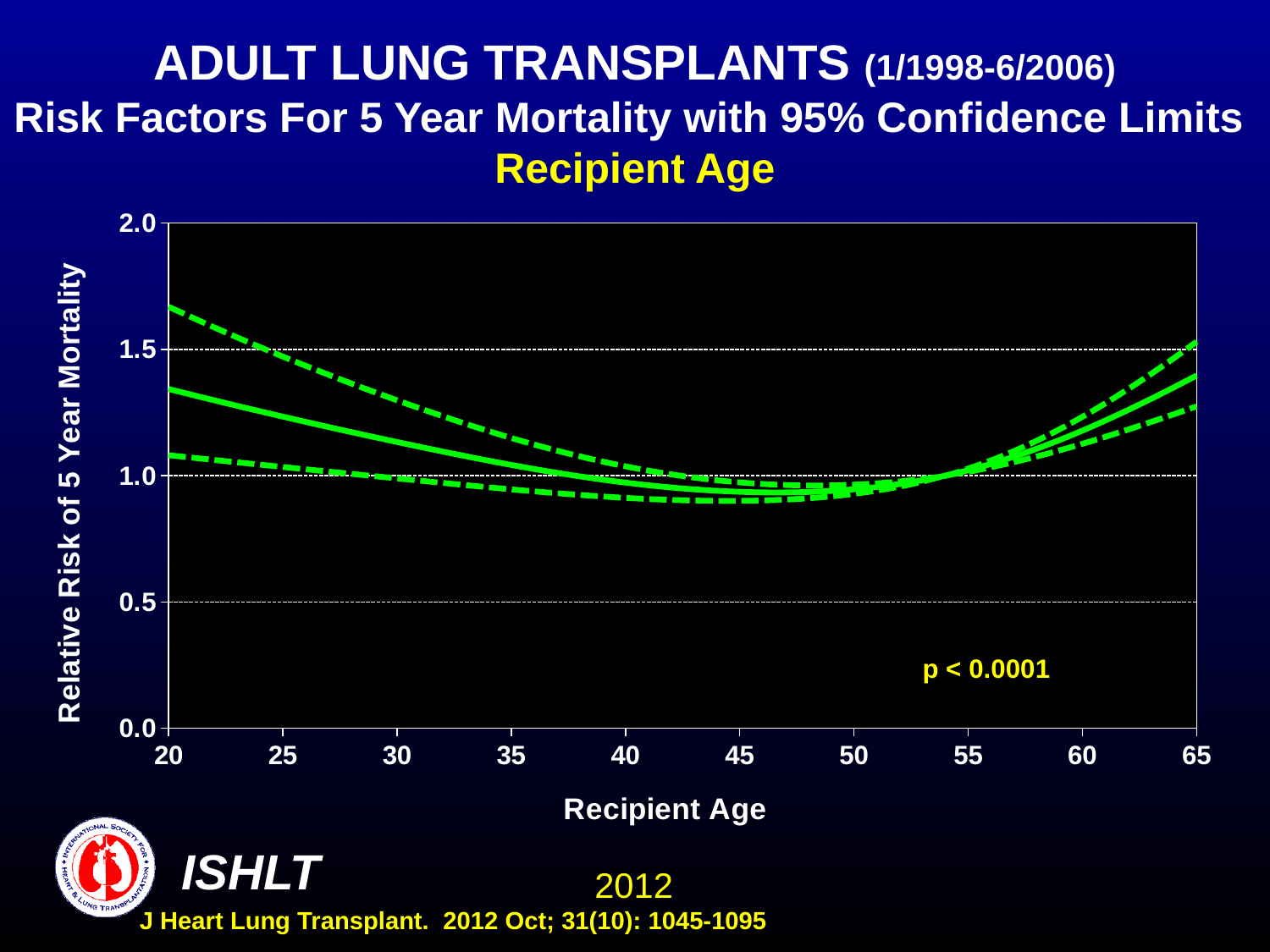
What p-value is printed on the chart? p < 0.0001 How many lines are plotted on the chart? 3 Is the relative risk (solid line) at recipient age 45 greater or less than 1.0? less Does the relative risk (solid line) rise or fall as recipient age increases from 20 to 45? fall What kind of chart is shown on the slide? line chart Does the relative risk (solid line) rise or fall as recipient age increases from 55 to 65? rise Is the relative risk (solid line) at recipient age 20 greater or less than 1.0? greater Is the relative risk (solid line) at recipient age 65 greater or less than 1.0? greater Which has the higher relative risk (solid line): recipient age 20 or recipient age 45? recipient age 20 What is the label of the y axis? Relative Risk of 5 Year Mortality